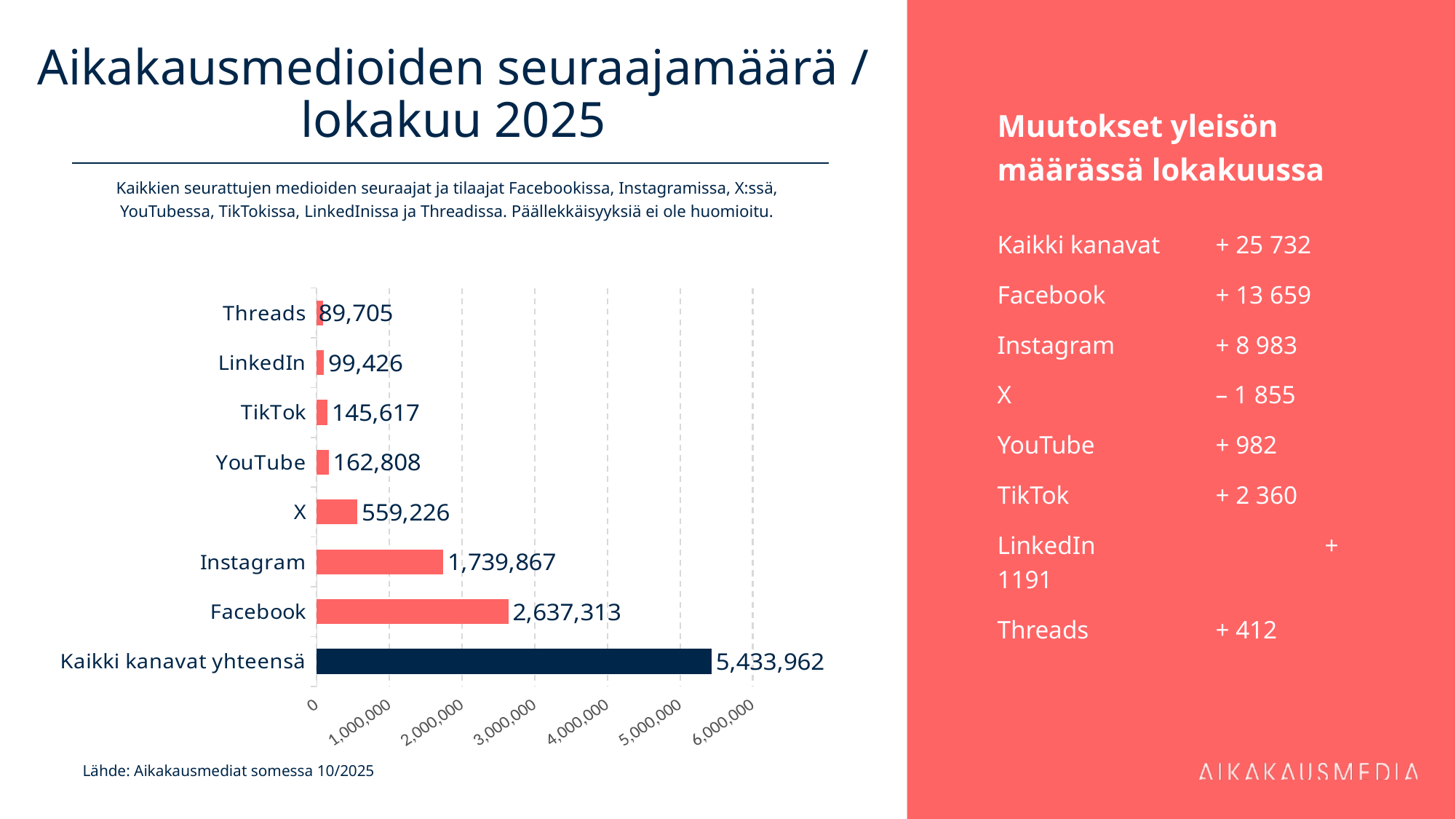
What kind of chart is shown on the slide? Bar chart What is the value for Facebook in the chart? 2,637,313 Which category has the highest value in the chart? Kaikki kanavat yhteensä What is the value shown for Kaikki kanavat yhteensä? 5,433,962 Which category has the lowest value in the chart? Threads What is the value for Instagram in the chart? 1,739,867 What is the difference between the values for YouTube and TikTok? 17,191 What is the value for X in the chart? 559,226 Which has a larger value, LinkedIn or TikTok? TikTok How many categories are shown in the chart? 8 What is the difference between the values for Facebook and Instagram? 897,446 What is the value for Threads in the chart? 89,705